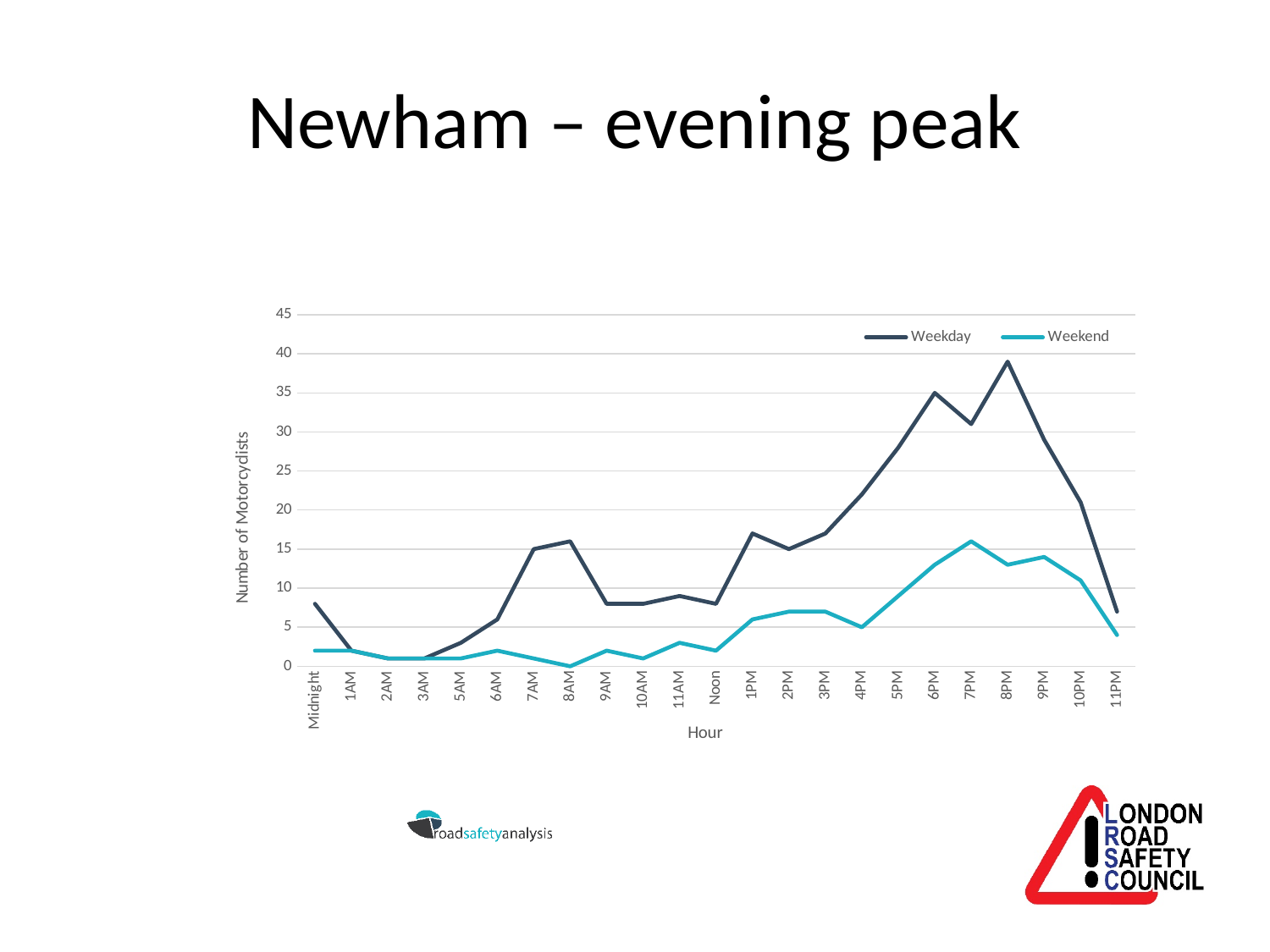
Is the Weekday value at 8PM greater or less than 35? greater Is the Weekend value at 7PM greater or less than 20? less Which series has the larger value at 6PM, Weekday or Weekend? Weekday At which hour does the Weekend series reach its highest value? 7PM What are the two series named in the legend? Weekday and Weekend What kind of chart is shown on the slide? line chart What is the Weekday value at 6PM? 35 Does the Weekday series rise or fall between 8PM and 11PM? fall How many hour categories are shown on the x axis? 23 How many series does the legend list? 2 At which hour does the Weekend series reach its lowest value? 8AM At which hour does the Weekday series reach its highest value? 8PM